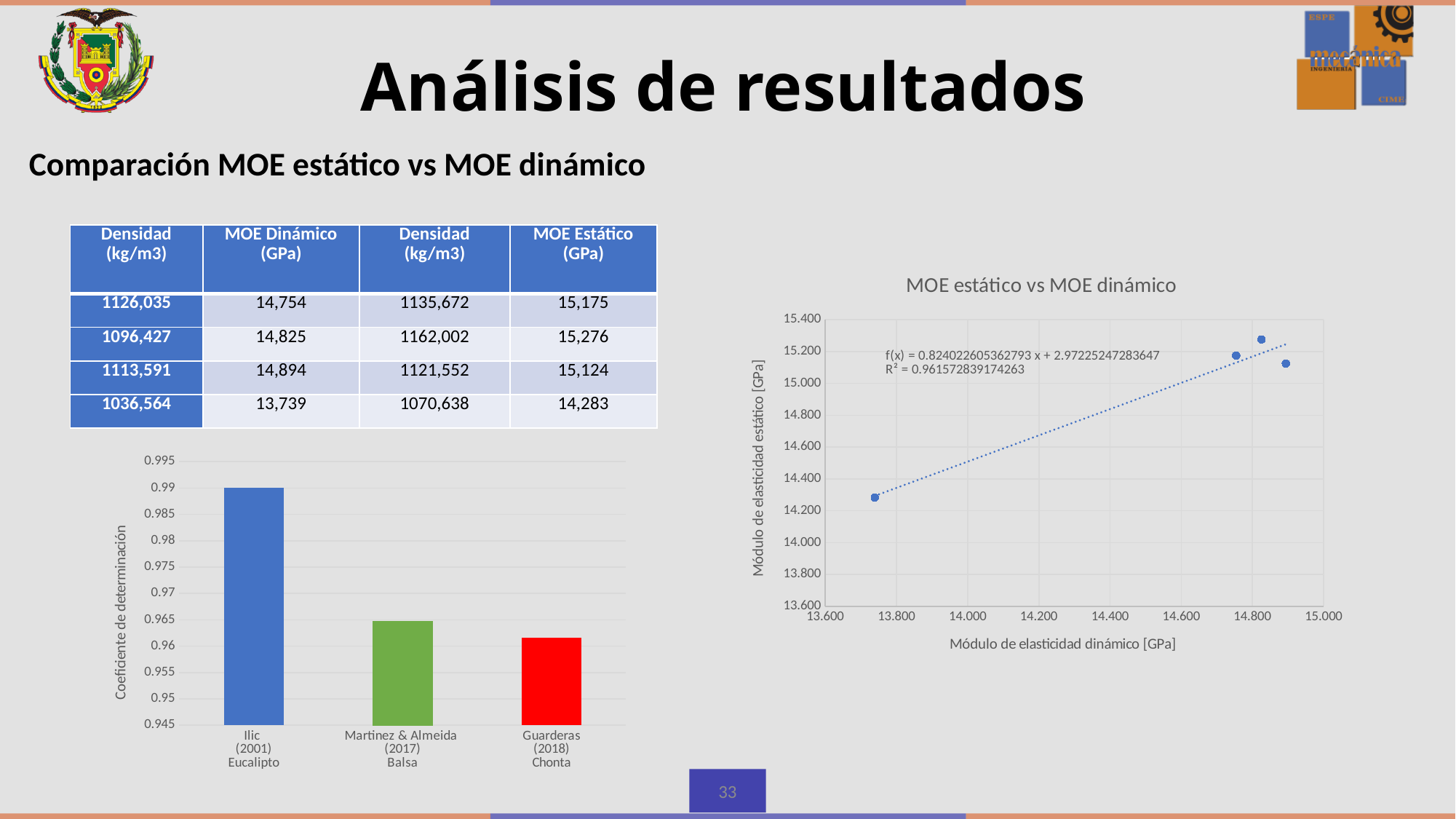
In the bottom-left bar chart, which is larger: the value for Martinez & Almeida (2017) Balsa or the value for Guarderas (2018) Chonta? Martinez & Almeida (2017) Balsa What kind of chart is the bottom-left chart showing the coefficient of determination? bar chart In the chart titled 'MOE estático vs MOE dinámico', how many data points are plotted? 4 In the bottom-left bar chart, is the value for Guarderas (2018) Chonta greater or less than 0.965? less In the bottom-left bar chart, what is the coefficient of determination for Ilic (2001) Eucalipto? 0.99 In the bottom-left bar chart, is the value for Martinez & Almeida (2017) Balsa greater or less than 0.96? greater In the chart titled 'MOE estático vs MOE dinámico', what is the R² value shown for the trendline? 0.961572839174263 In the bottom-left bar chart, which category has the lowest coefficient of determination? Guarderas (2018) Chonta In the bottom-left bar chart, what colour is the bar for Guarderas (2018) Chonta? red In the bottom-left bar chart, how many categories are shown? 3 In the chart titled 'MOE estático vs MOE dinámico', do the values generally rise or fall as the dynamic modulus increases? rise In the bottom-left bar chart, which category has the highest coefficient of determination? Ilic (2001) Eucalipto